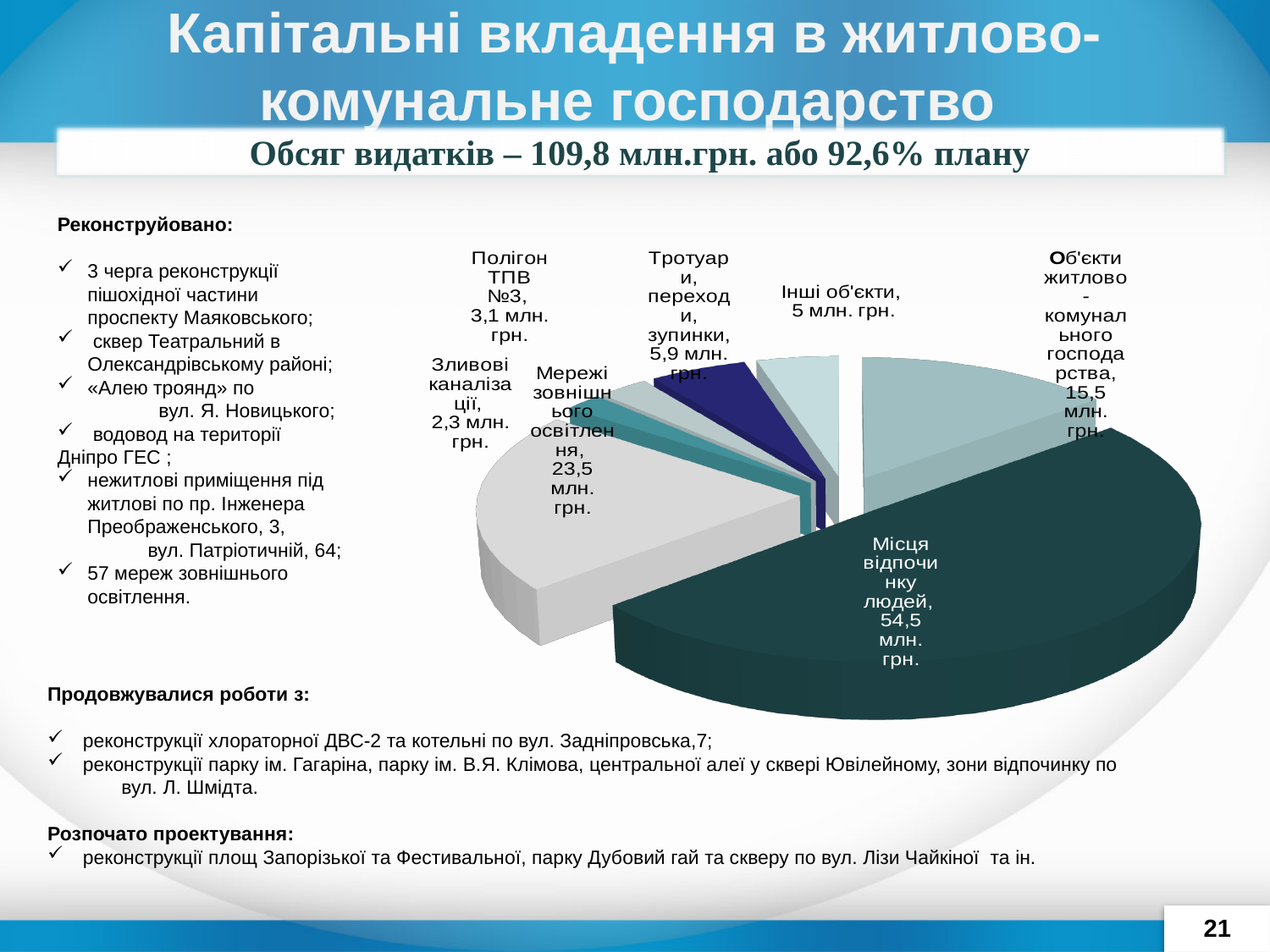
What type of chart is shown on the slide? pie chart What is the total of all slices in the pie chart? 109,8 млн. грн. What is the difference between "Місця відпочинку людей" and "Мережі зовнішнього освітлення"? 31 млн. грн. Which is larger: "Полігон ТПВ №3" or "Тротуари, переходи, зупинки"? Тротуари, переходи, зупинки Which category has the largest slice in the pie chart? Місця відпочинку людей Which category has the smallest slice in the pie chart? Зливові каналізації What is the difference between "Тротуари, переходи, зупинки" and "Інші об'єкти"? 0,9 млн. грн. What is the value for "Об'єкти житлово-комунального господарства" in the pie chart? 15,5 млн. грн. What is the value for "Зливові каналізації" in the pie chart? 2,3 млн. грн. How many slices does the pie chart have? 7 What is the value for "Мережі зовнішнього освітлення" in the pie chart? 23,5 млн. грн. What is the value for "Місця відпочинку людей" in the pie chart? 54,5 млн. грн.